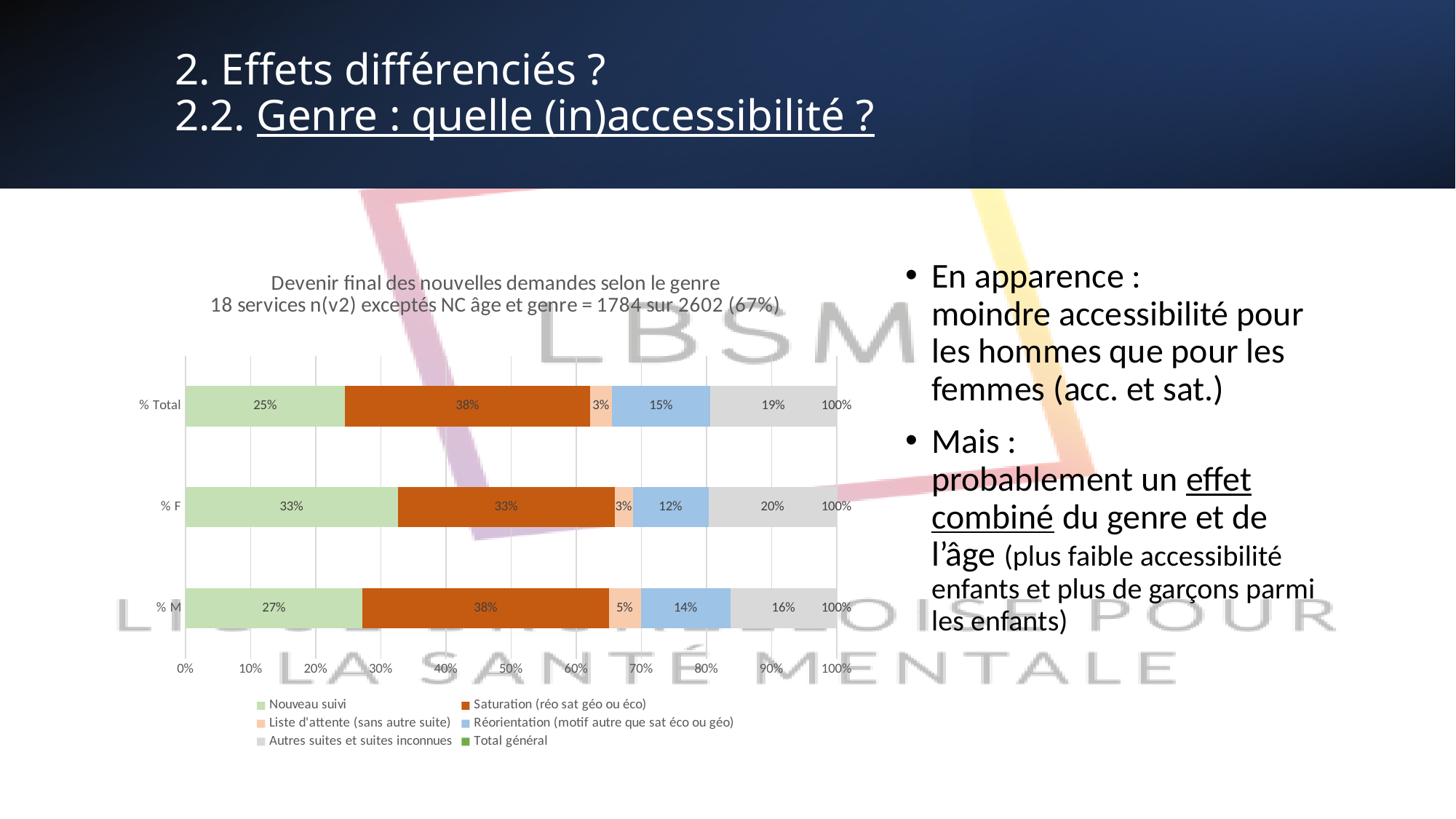
How many categories are shown on the vertical axis of the chart? 3 What is the value of "Liste d'attente (sans autre suite)" for the "% M" category? 5% Which category has the highest value for "Nouveau suivi"? % F How many series does the chart legend list? 6 What is the difference between the "Nouveau suivi" values for "% F" and "% M"? 6% What kind of chart is shown on the slide? Stacked bar chart What is the value of "Nouveau suivi" for the "% F" category? 33% Which is larger: the "Saturation (réo sat géo ou éco)" value for "% F" or for "% M"? % M Which category has the lowest value for "Réorientation (motif autre que sat éco ou géo)"? % F What is the value of "Réorientation (motif autre que sat éco ou géo)" for the "% Total" category? 15% What is the value of "Autres suites et suites inconnues" for the "% F" category? 20% What is the value of "Saturation (réo sat géo ou éco)" for the "% M" category? 38%